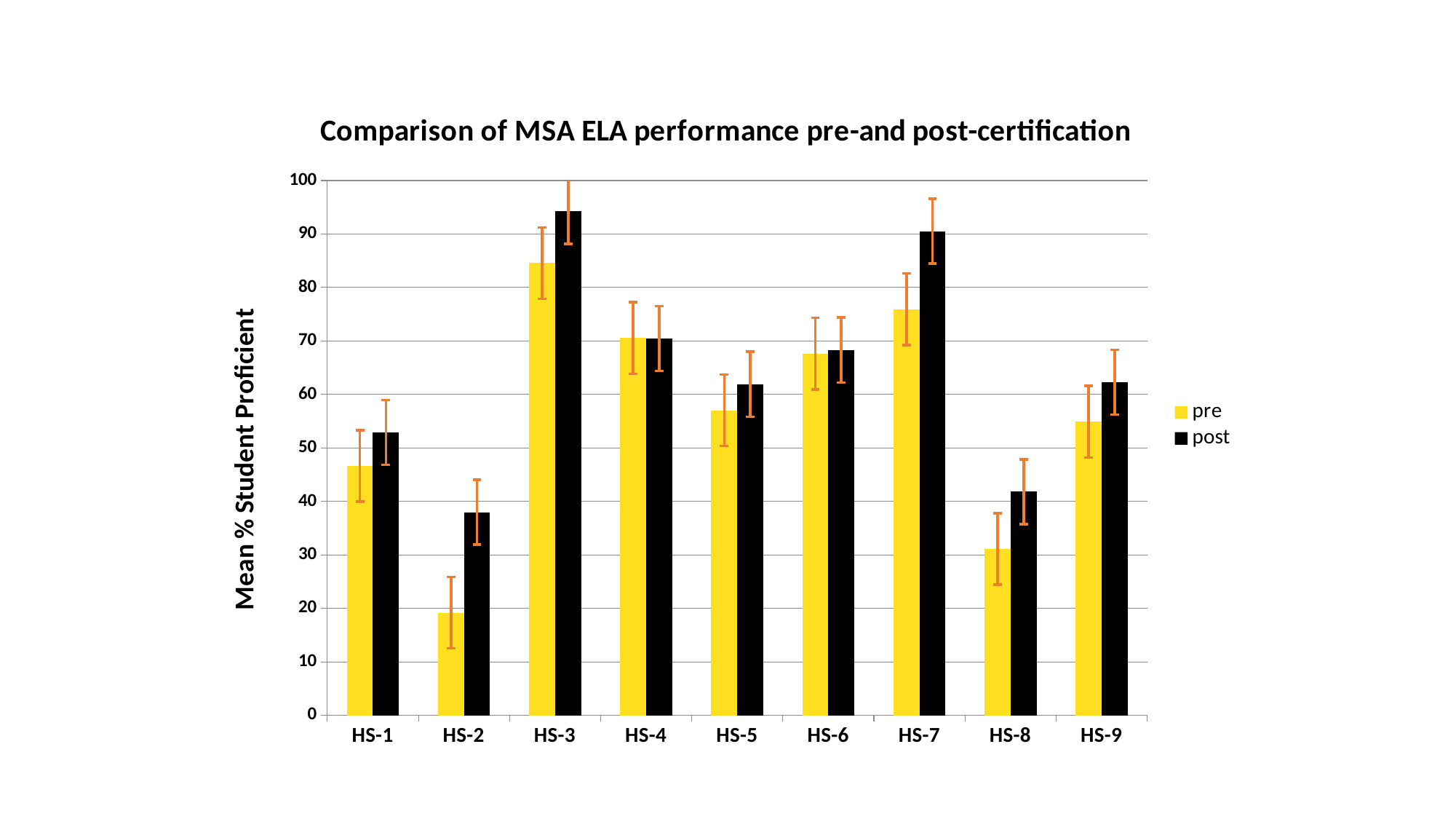
How many high schools (categories) are shown on the x axis? 9 For HS-8, which is larger, the pre value or the post value? post Which high school has the highest pre-certification value? HS-3 Which high school has the lowest post-certification value? HS-2 Is the post value for HS-3 greater or less than 90? greater Which is larger, the pre value for HS-7 or the pre value for HS-9? HS-7 What kind of chart is shown on the slide? bar chart How many series does the legend list? 2 Which high school has the lowest pre-certification value? HS-2 Is the post value for HS-7 greater or less than 80? greater What is the label on the y axis? Mean % Student Proficient